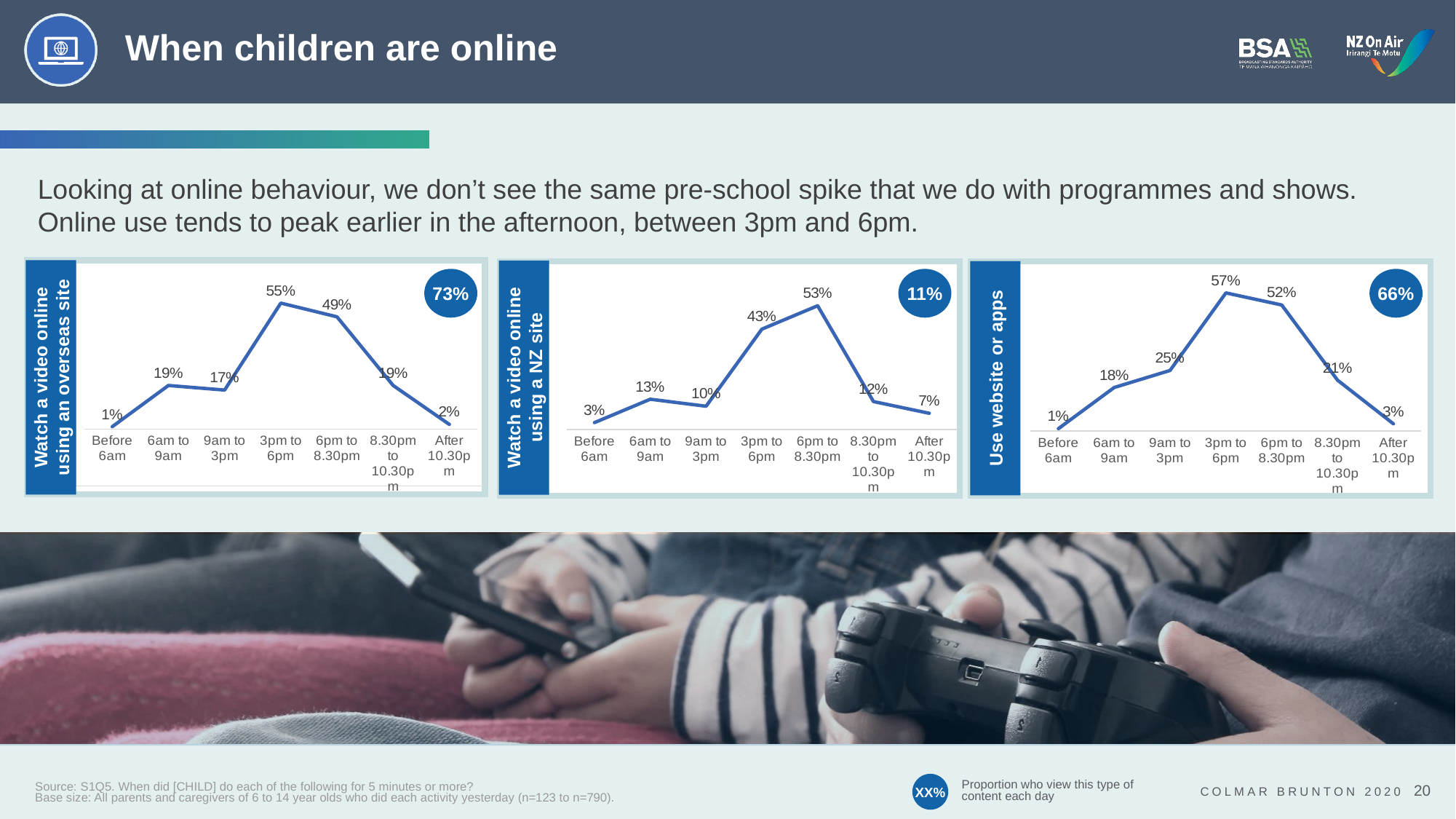
What type of chart is used in the 'Use website or apps' panel? Line chart How many time periods are shown on the x axis of the 'Watch a video online using a NZ site' chart? 7 In the 'Use website or apps' chart, what is the value for 6am to 9am? 18% In the 'Use website or apps' chart, which time period has the highest value? 3pm to 6pm What is the proportion shown in the circle for the 'Watch a video online using a NZ site' chart? 11% In the 'Watch a video online using an overseas site' chart, what is the difference between the 3pm to 6pm value and the 6pm to 8.30pm value? 6% In the 'Watch a video online using a NZ site' chart, which time period has the lowest value? Before 6am In the 'Watch a video online using a NZ site' chart, what is the value for 6pm to 8.30pm? 53% In the 'Watch a video online using an overseas site' chart, what is the value for 3pm to 6pm? 55% In the 'Use website or apps' chart, which is larger: the value for 9am to 3pm or the value for 8.30pm to 10.30pm? 9am to 3pm What is the proportion shown in the circle for the 'Watch a video online using an overseas site' chart? 73% In the 'Watch a video online using a NZ site' chart, do values rise or fall from 6pm to 8.30pm through to After 10.30pm? Fall